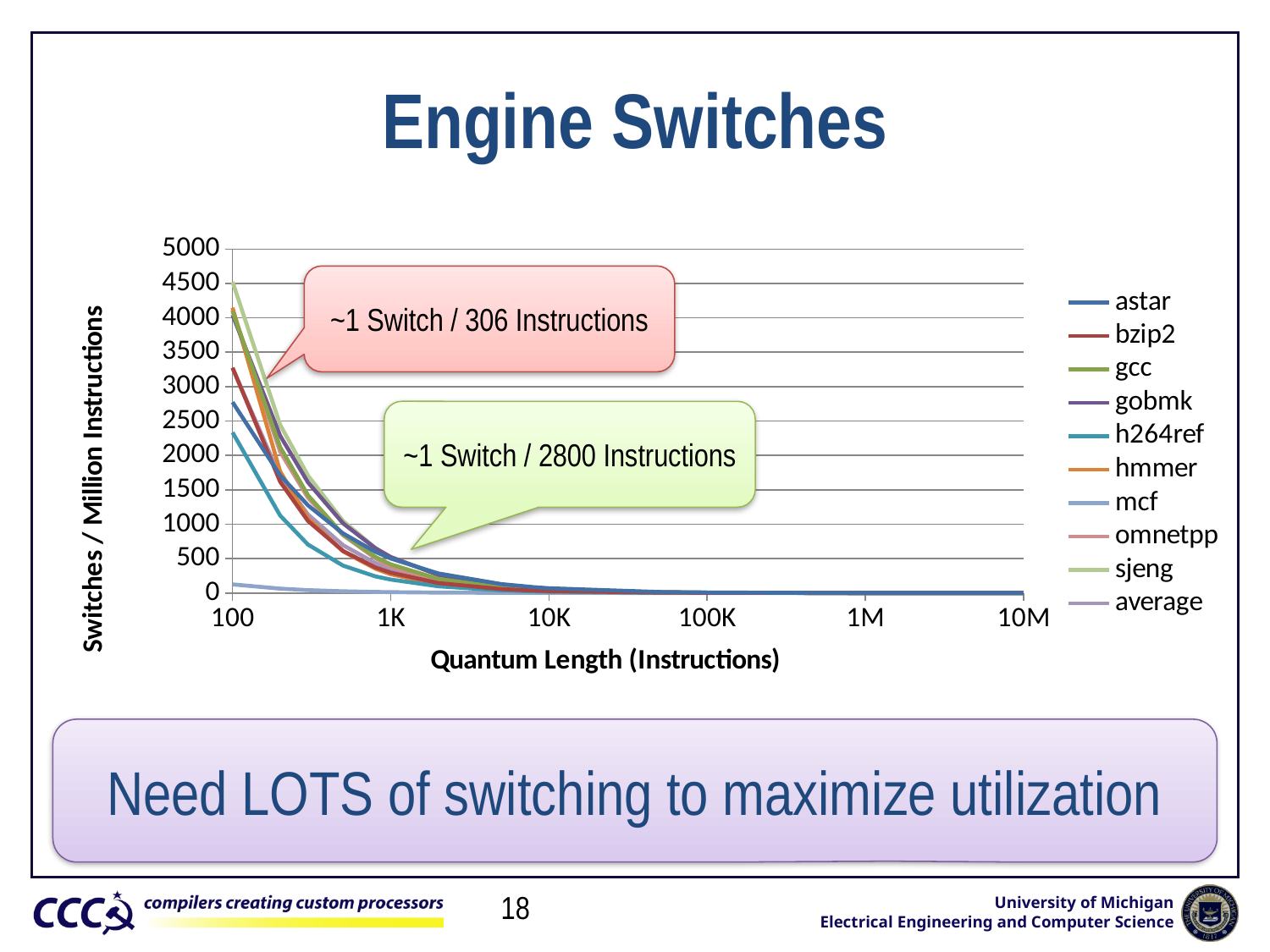
Is the value for sjeng at a quantum length of 100 greater or less than 4000? greater Is the value for mcf at a quantum length of 100 greater or less than 500? less Do the values rise or fall as the quantum length increases along the x axis? fall Which series has the lowest value at a quantum length of 100? mcf How many series does the legend list? 10 What is the title of the y axis? Switches / Million Instructions What kind of chart is shown on the slide? line chart At a quantum length of 100, which is larger, the value for gcc or the value for h264ref? gcc What is the title of the x axis? Quantum Length (Instructions) How many tick labels are shown on the x axis (Quantum Length)? 6 Which series has the highest value at a quantum length of 100? sjeng Is the value for h264ref at a quantum length of 100 greater or less than 2500? less